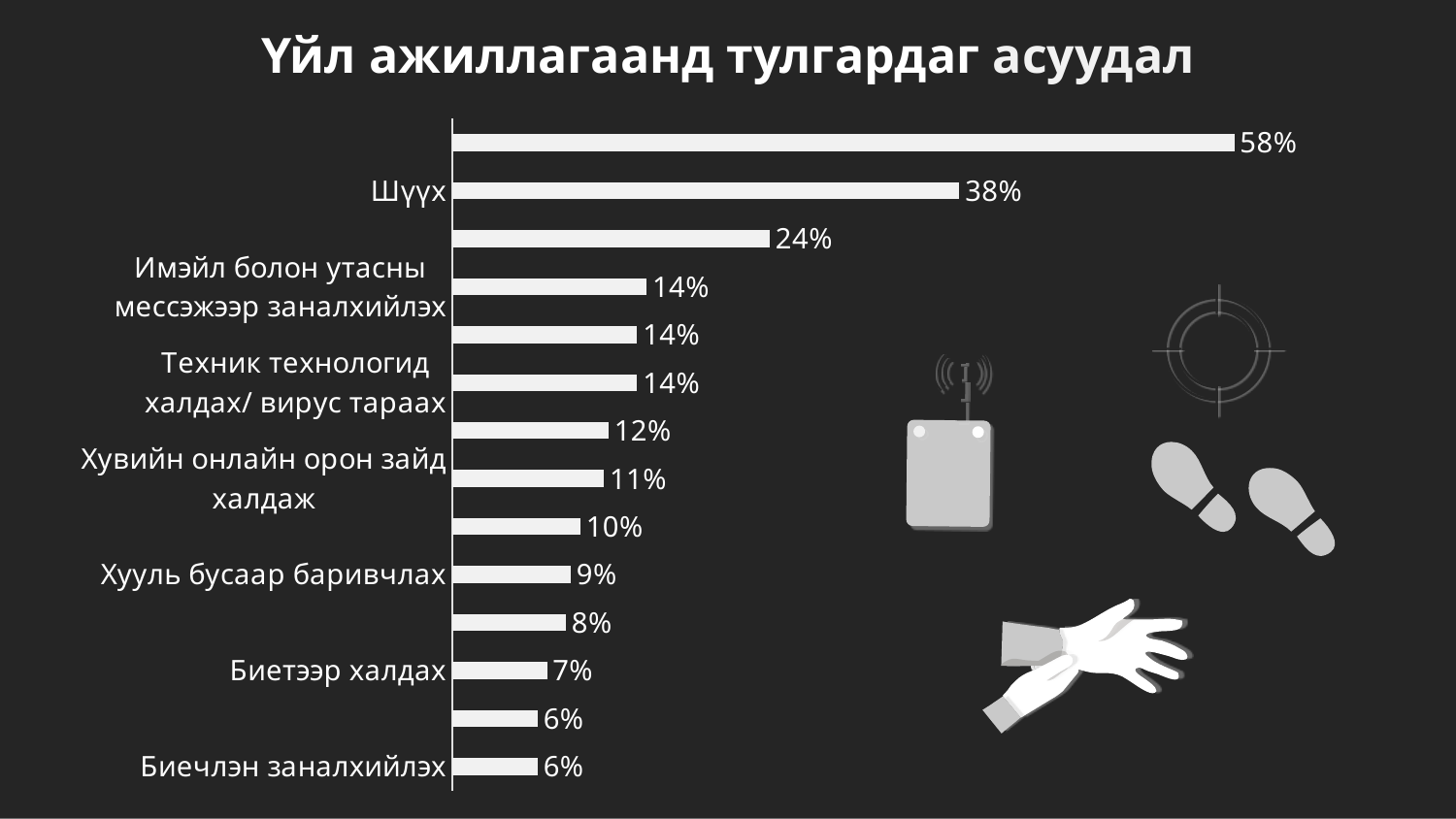
What is the value for Биечлэн заналхийлэх? 6% What is the value for Хууль бусаар баривчлах? 9% What is the title of the slide? Үйл ажиллагаанд тулгардаг асуудал How many bars are plotted on the chart? 14 What is the largest value shown on the chart? 58% What is the value for Техник технологид халдах/ вирус тараах? 14% What is the value for Биетээр халдах? 7% What kind of chart is shown on the slide? Bar chart Which is larger, the value for Хууль бусаар баривчлах or the value for Биечлэн заналхийлэх? Хууль бусаар баривчлах What is the difference between the values for Шүүх and Биетээр халдах? 31 percentage points What is the value for Шүүх? 38% What is the value for Хувийн онлайн орон зайд халдаж? 11%